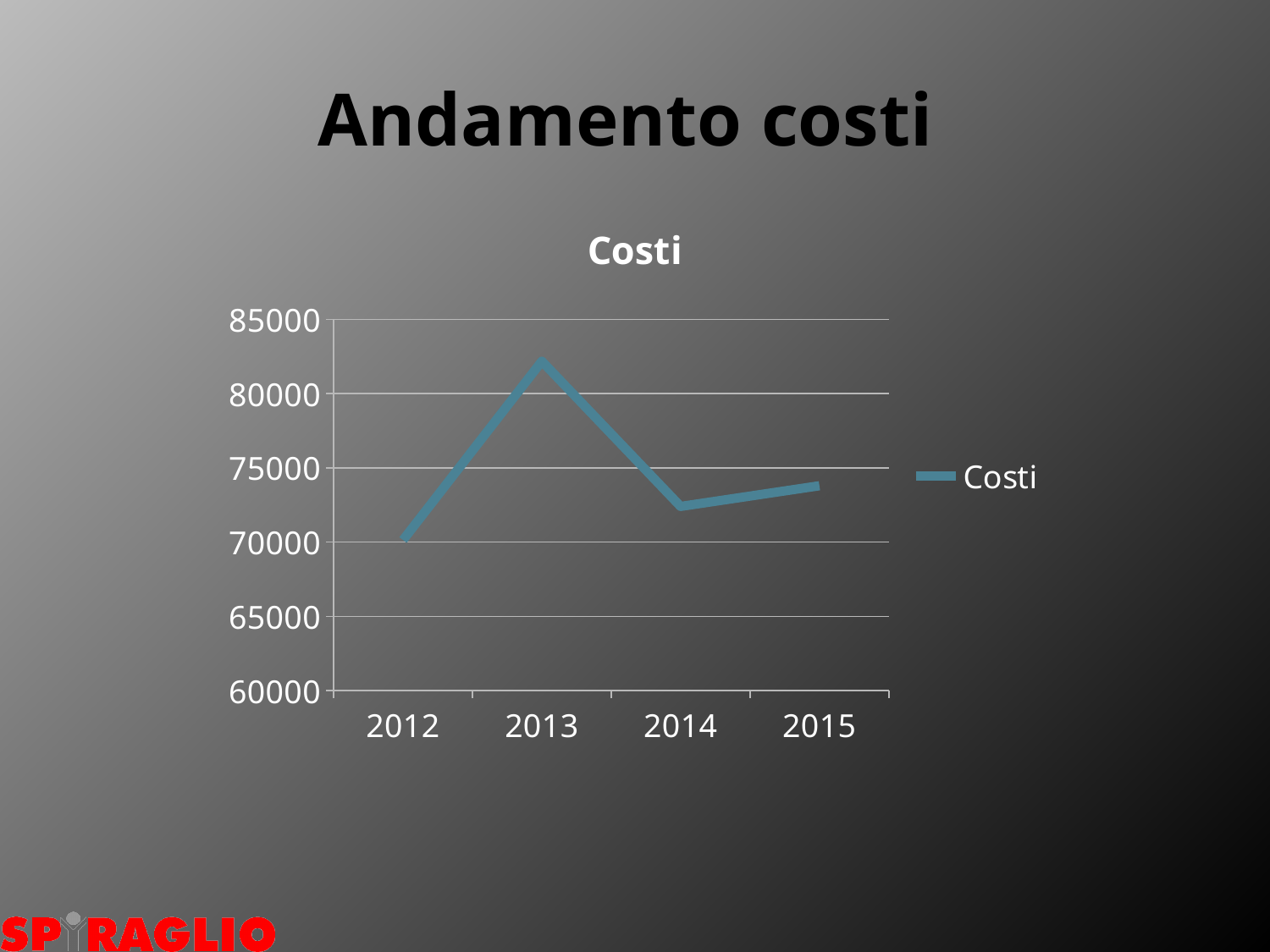
Is the value for Costi in 2014 greater or less than 75000? less Which year has the lowest value for Costi? 2012 Does the value for Costi rise or fall from 2013 to 2014? fall Is the value for Costi in 2015 greater or less than 75000? less How many series does the legend list? 1 Is the value for Costi in 2013 greater or less than 80000? greater Which year has the highest value for Costi? 2013 How many years are plotted on the x axis? 4 What is the title of the chart? Costi Which is larger, the value for Costi in 2013 or in 2014? 2013 What kind of chart is shown on the slide? line chart Which is larger, the value for Costi in 2012 or in 2015? 2015